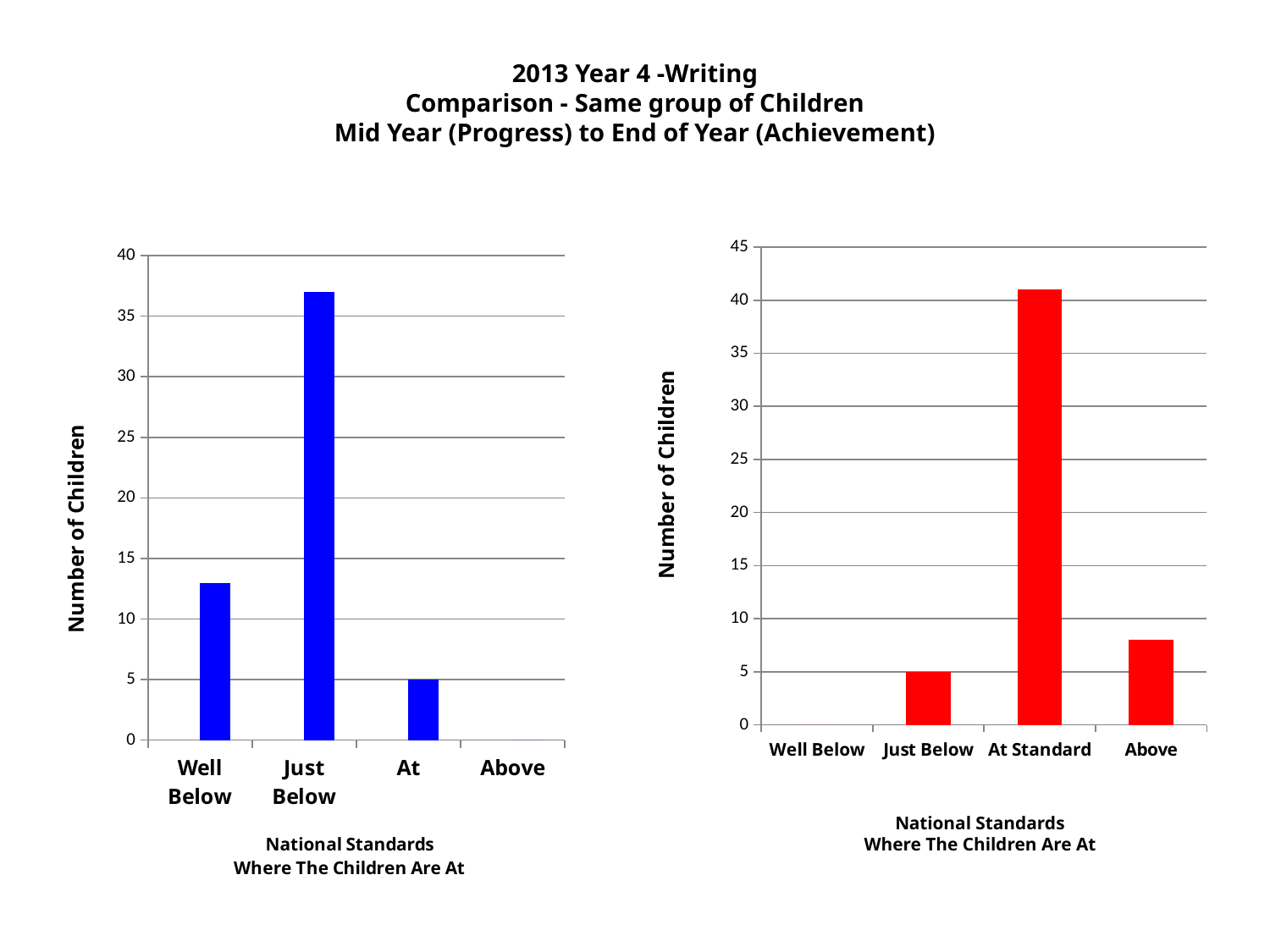
What kind of chart is the left chart on the slide? bar chart In the right (red) chart, is the value for Above greater or less than 10? less How many categories are shown on the x axis of the right (red) chart? 4 In the right (red) chart, is the value for At Standard greater or less than 40? greater What is the y-axis title of the left (blue) chart? Number of Children In the left (blue) chart, is the value for Just Below greater or less than 35? greater In the right (red) chart, which is larger, the value for Just Below or the value for Above? Above In the left (blue) chart, which category has the highest number of children? Just Below In the right (red) chart, which category has the highest number of children? At Standard In the right (red) chart, how many children are in the Just Below category? 5 In the left (blue) chart, how many children are in the At category? 5